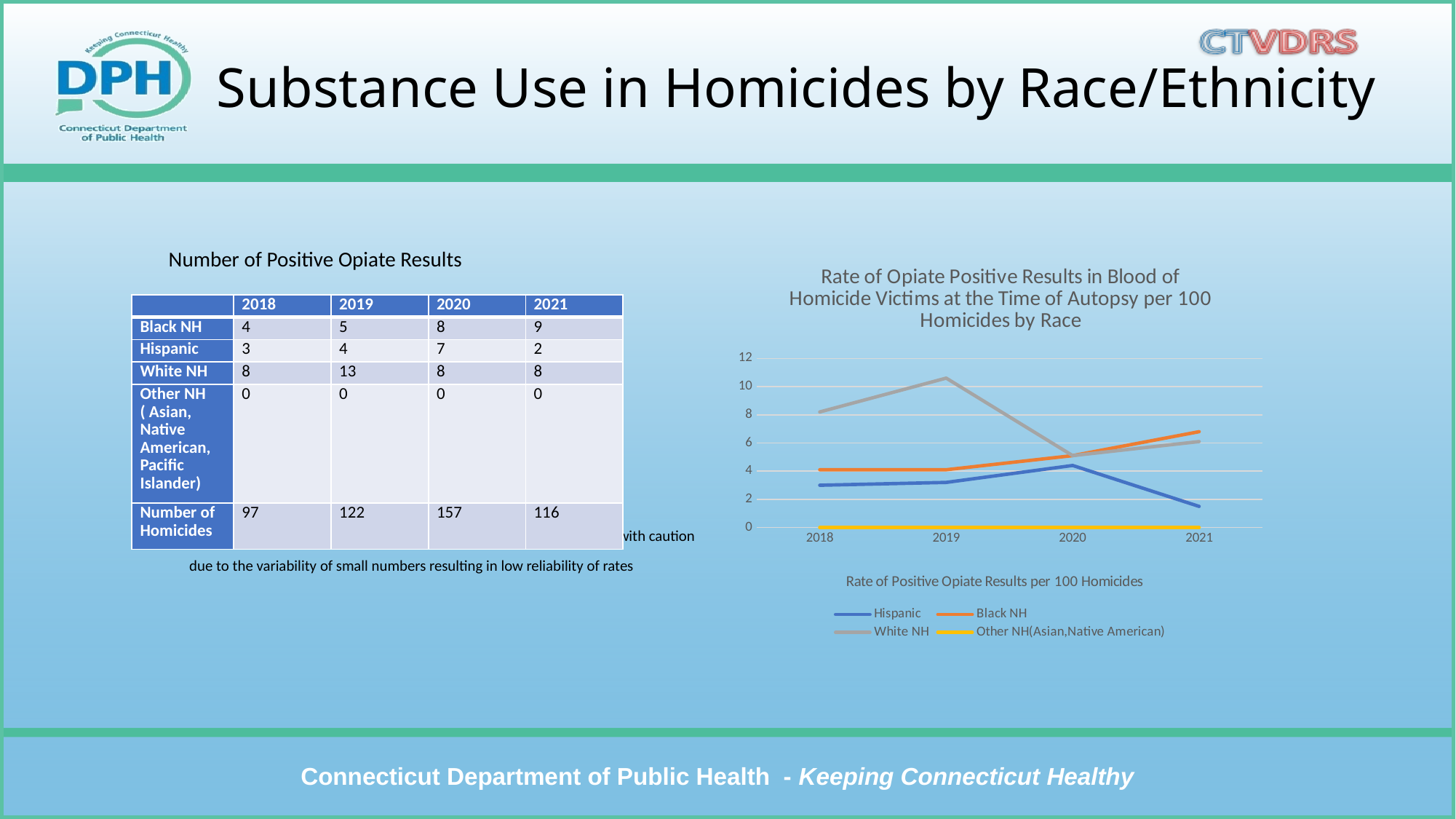
Which race/ethnicity group has the highest rate in 2019? White NH In 2021, which is larger: the Black NH rate or the White NH rate? Black NH Which race/ethnicity group has the lowest rate in 2021? Other NH(Asian,Native American) Is the White NH rate in 2019 greater or less than 10? greater How many years are shown on the x axis of the chart? 4 Does the Black NH rate rise or fall from 2018 to 2021? rise Is the Hispanic rate in 2021 greater or less than 2? less What kind of chart is shown on the slide? line chart How many series does the chart legend list? 4 Is the Black NH rate in 2021 greater or less than 6? greater What colour is the line for Other NH(Asian,Native American) in the chart? yellow In which year is the White NH rate highest? 2019